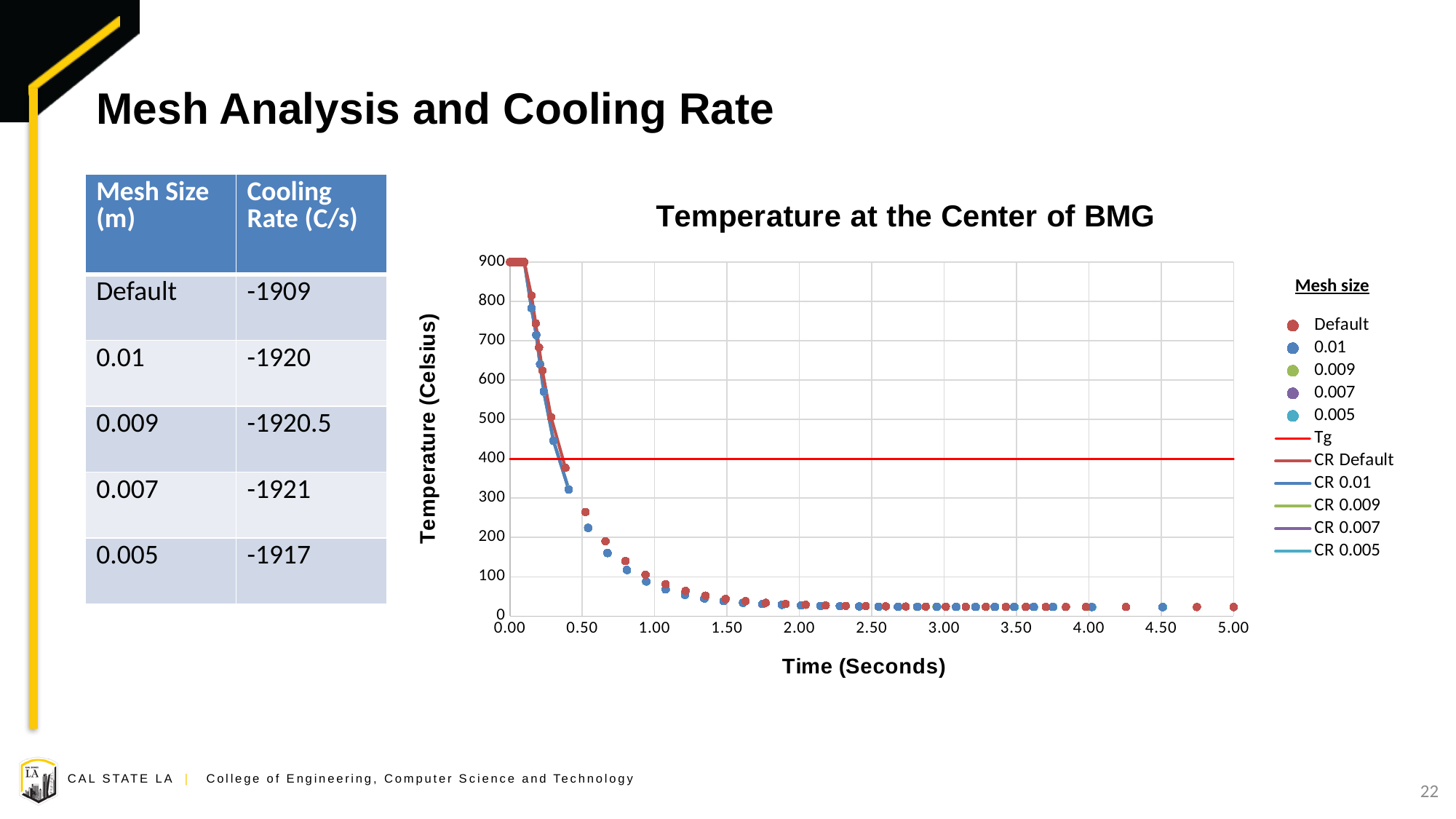
In the "Temperature at the Center of BMG" chart, is the Default series temperature at 1.00 seconds greater or less than 200? less In the "Temperature at the Center of BMG" chart, what is the maximum value shown on the Time axis? 5.00 What is the label of the x axis of the "Temperature at the Center of BMG" chart? Time (Seconds) How many entries does the legend of the "Temperature at the Center of BMG" chart list? 11 What is the title of the chart on the slide? Temperature at the Center of BMG In the "Temperature at the Center of BMG" chart, what is the temperature of the data series at time 0.00 seconds? 900 In the "Temperature at the Center of BMG" chart, do the temperature values rise or fall as time increases? fall In the "Temperature at the Center of BMG" chart, which is higher: the temperature at 0.50 seconds or the temperature at 2.00 seconds? 0.50 seconds What kind of chart is "Temperature at the Center of BMG"? scatter chart In the "Temperature at the Center of BMG" chart, at what temperature is the horizontal Tg line drawn? 400 In the "Temperature at the Center of BMG" chart, is the temperature at 5.00 seconds greater or less than 100? less In the "Temperature at the Center of BMG" chart, is the Default series temperature at 0.50 seconds greater or less than 200? greater